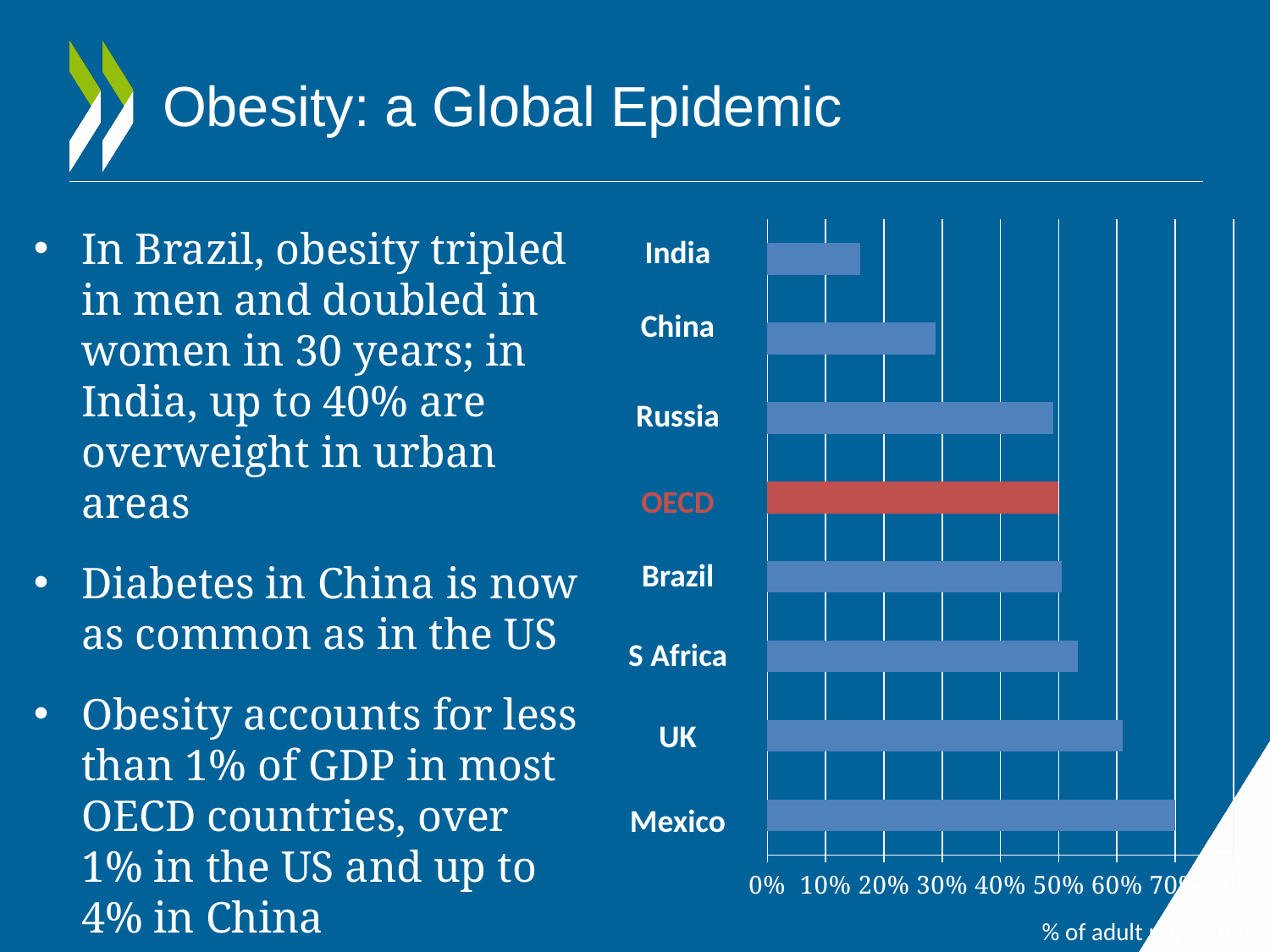
What kind of chart is shown on the slide? bar chart Is the value for Russia greater or less than 40%? greater Which category has the shortest bar in the chart? India How many categories are plotted in the bar chart? 8 Which has the larger value, India or China? China Is the value for China greater or less than 20%? greater Which has the larger value, UK or Mexico? Mexico Which category's bar is shown in a different colour (red) from the others? OECD Is the value for India greater or less than 20%? less Which category has the longest bar in the chart? Mexico